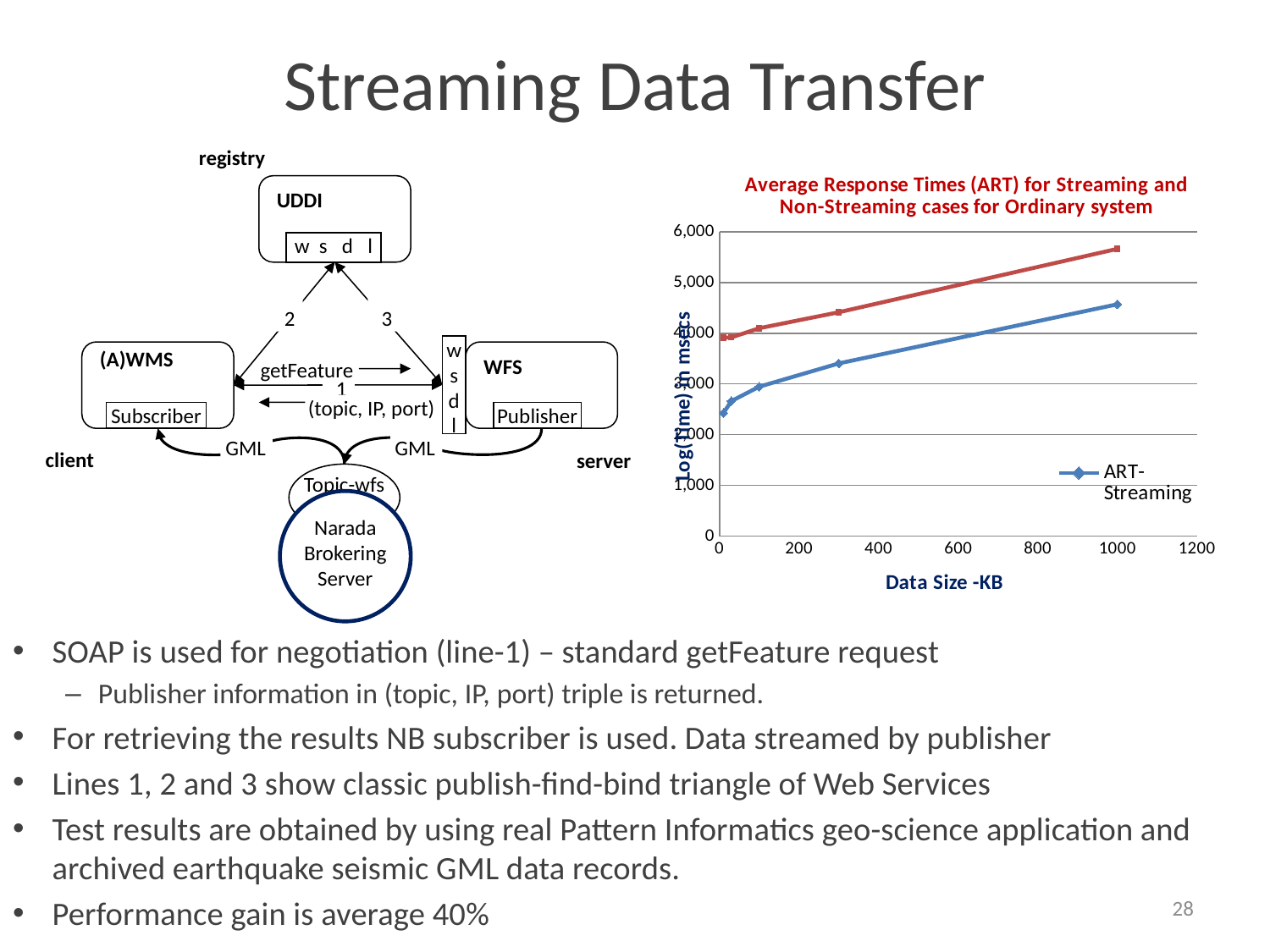
How many data points are marked on the ART-Streaming line? 5 At 1000 KB, which line is higher: the red line or the blue ART-Streaming line? the red line How many lines are plotted on the chart? 2 Is the red line's value near 0 KB greater or less than 3,000? greater What is the title of the chart on the slide? Average Response Times (ART) for Streaming and Non-Streaming cases for Ordinary system What is the x-axis title of the chart? Data Size -KB Is the red line's value at 1000 KB greater or less than 5,000? greater Is the ART-Streaming value at 1000 KB greater or less than 4,000? greater What kind of chart is shown on the slide? line chart Does the ART-Streaming line rise or fall as data size increases? rises